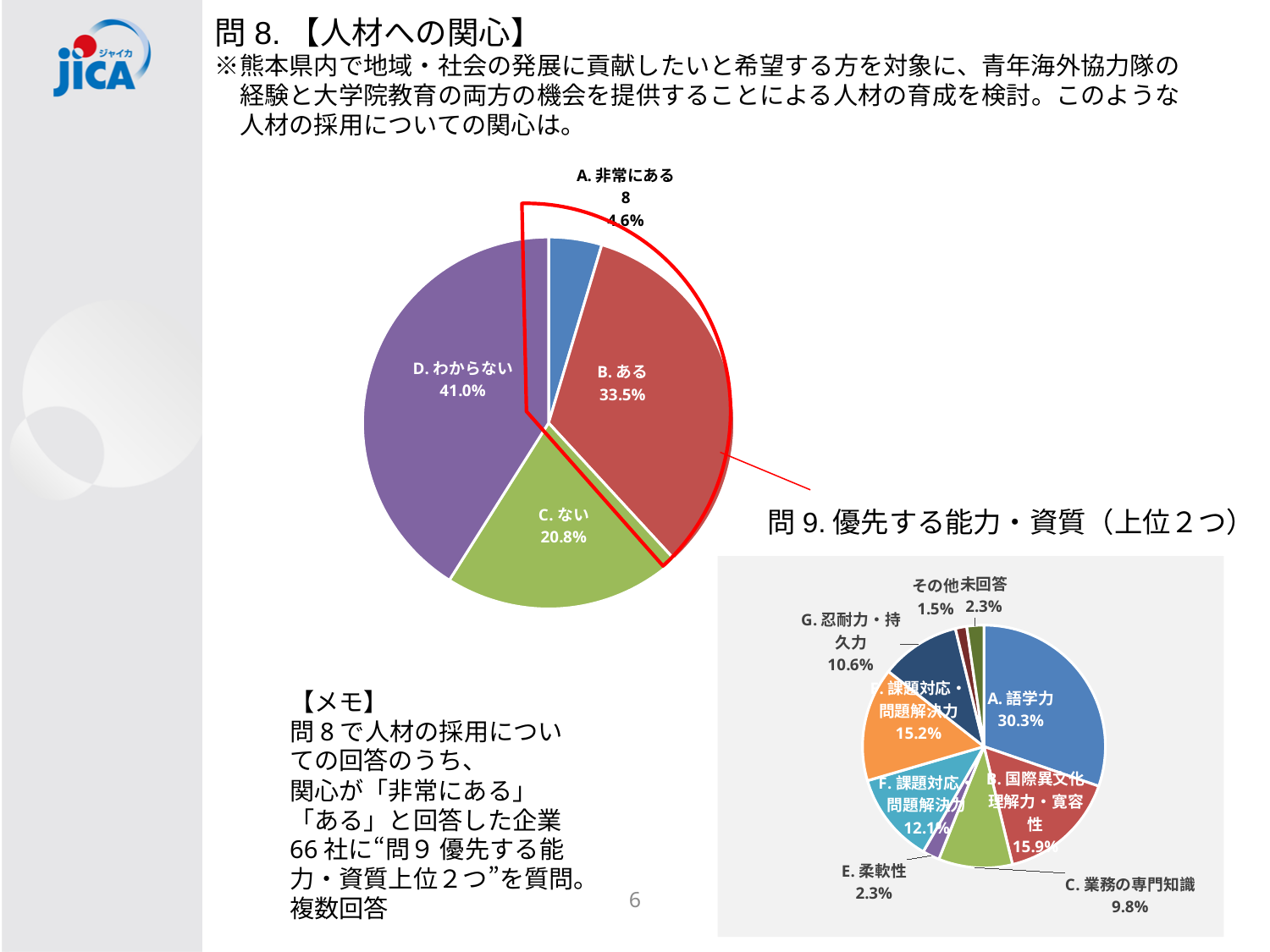
In the 問9 pie chart (bottom right), what is the difference in percentage points between A. 語学力 and B. 国際異文化理解力・寛容性? 14.4 In the 問8 pie chart (left), what is the difference in percentage points between B. ある and C. ない? 12.7 In the 問9 pie chart (bottom right), what percentage is shown for C. 業務の専門知識? 9.8% In the 問8 pie chart (left), how many categories are shown? 4 In the 問8 pie chart (left), what percentage is shown for B. ある? 33.5% In the 問9 pie chart (bottom right), which is larger, G. 忍耐力・持久力 or E. 柔軟性? G. 忍耐力・持久力 In the 問8 pie chart (left), which category has the smallest share? A. 非常にある What type of chart is used for 問8 on the left of the slide? Pie chart In the 問8 pie chart (left), which category has the largest share? D. わからない In the 問9 pie chart (bottom right), which category has the largest share? A. 語学力 In the 問9 pie chart (bottom right), what percentage is shown for A. 語学力? 30.3% In the 問8 pie chart (left), what percentage is shown for D. わからない? 41.0%